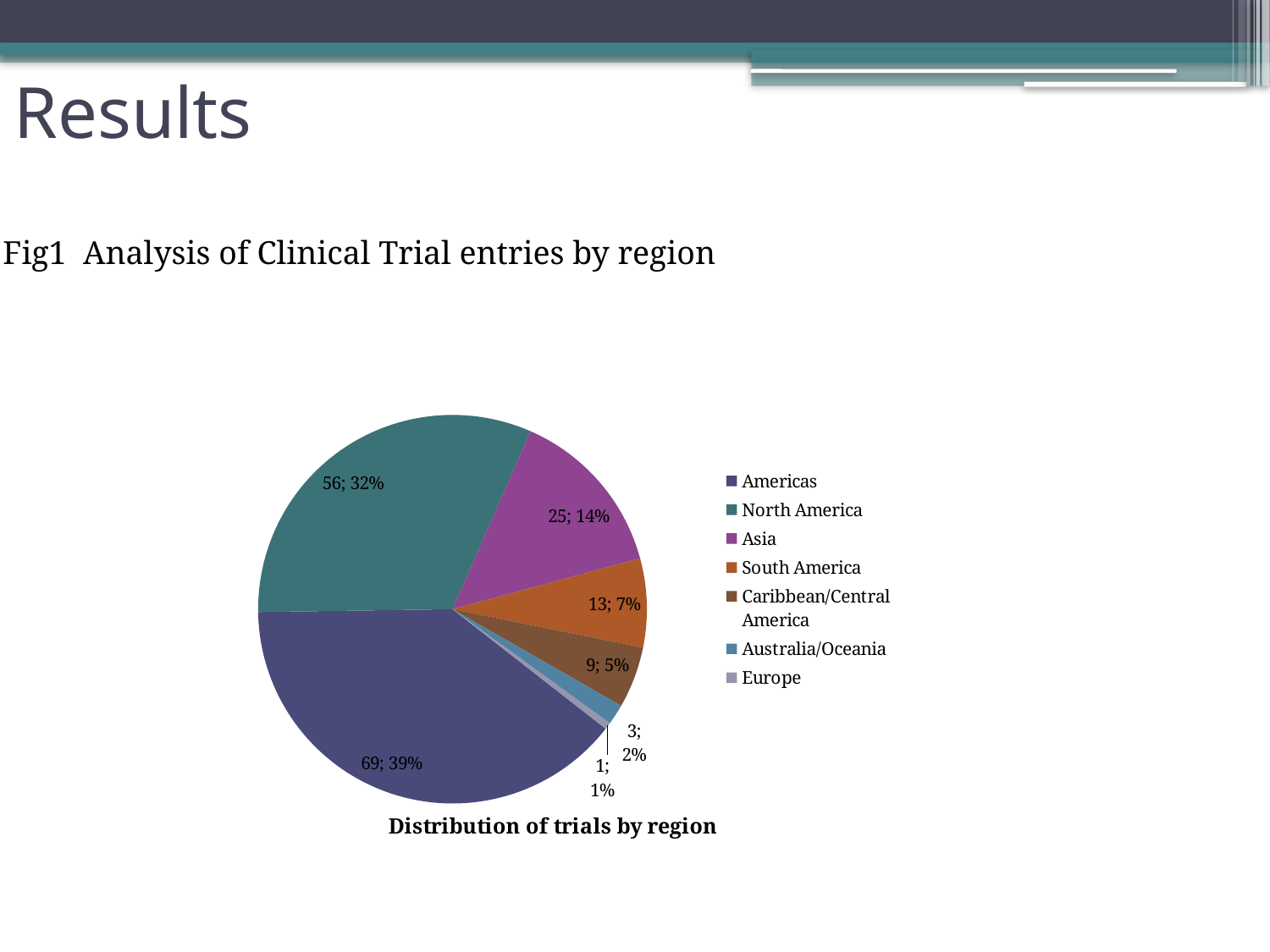
What percentage share of the pie does South America have? 7% How many trials are shown for Caribbean/Central America? 9 How many trials are shown for Asia? 25 What percentage share of the pie does North America have? 32% What kind of chart is shown on the slide? pie chart What is the title of the chart? Distribution of trials by region How many trials are shown for Americas? 69 Which has more trials, Asia or South America? Asia Which region has the smallest slice of the pie? Europe How many regions does the legend list? 7 Which region has the largest slice of the pie? Americas What is the difference in the number of trials between Americas and North America? 13